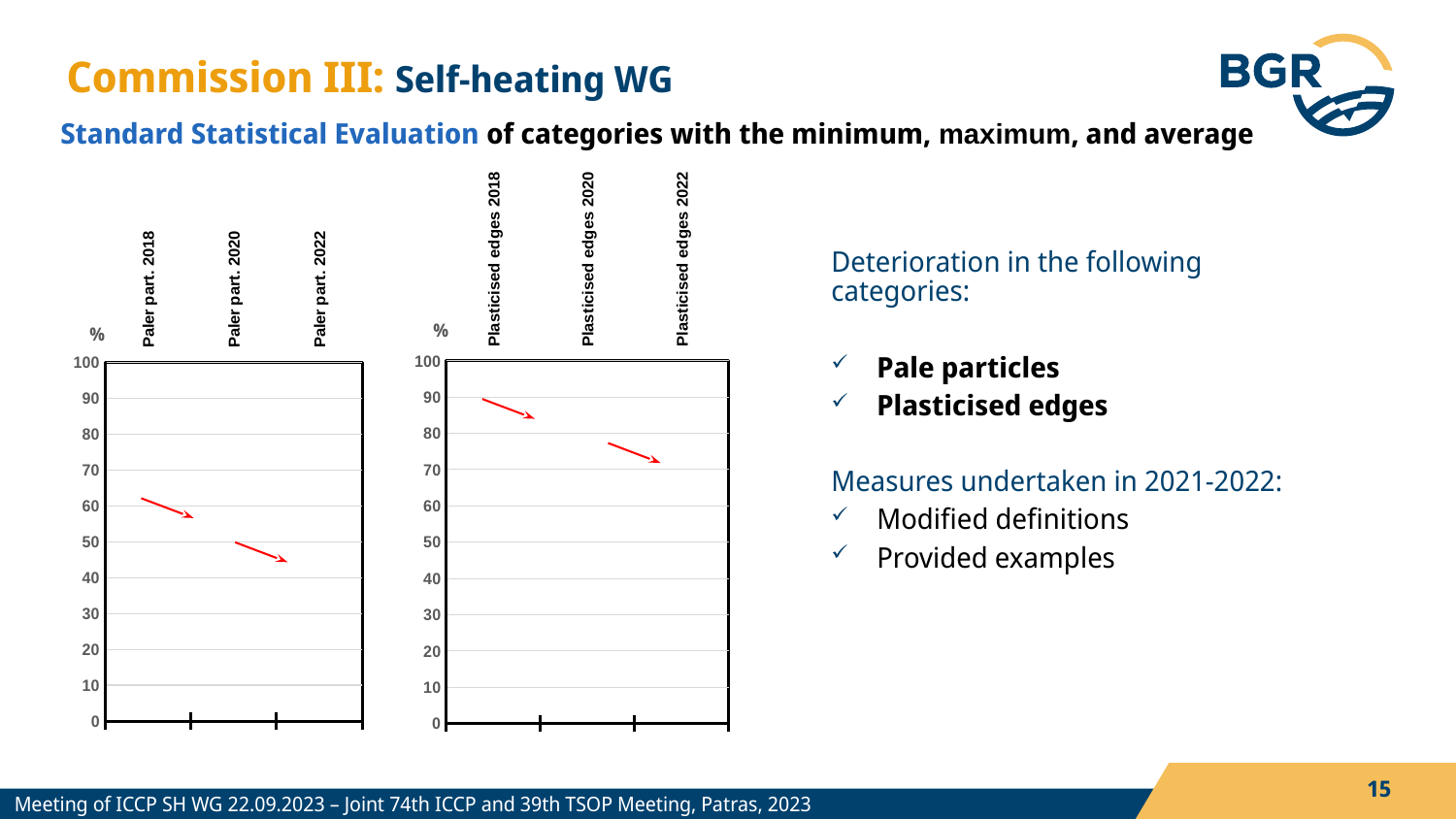
In the right chart (Plasticised edges), is the value for Plasticised edges 2022 greater or less than 80? less What is the maximum value shown on the y axis of the left chart (Paler part.)? 100 In the left chart (Paler part.), how many categories are shown on the x axis? 3 What unit is shown on the y axis of both charts? % In the left chart (Paler part.), which is larger, the value for Paler part. 2018 or Paler part. 2022? Paler part. 2018 In the right chart (Plasticised edges), how many categories are shown on the x axis? 3 In the right chart (Plasticised edges), do the values rise or fall from 2018 to 2022? fall In the left chart (Paler part.), do the values rise or fall from 2018 to 2022? fall In the right chart (Plasticised edges), which is larger, the value for Plasticised edges 2018 or Plasticised edges 2022? Plasticised edges 2018 In the right chart (Plasticised edges), is the value for Plasticised edges 2018 greater or less than 80? greater In the left chart (Paler part.), is the value for Paler part. 2018 greater or less than 50? greater